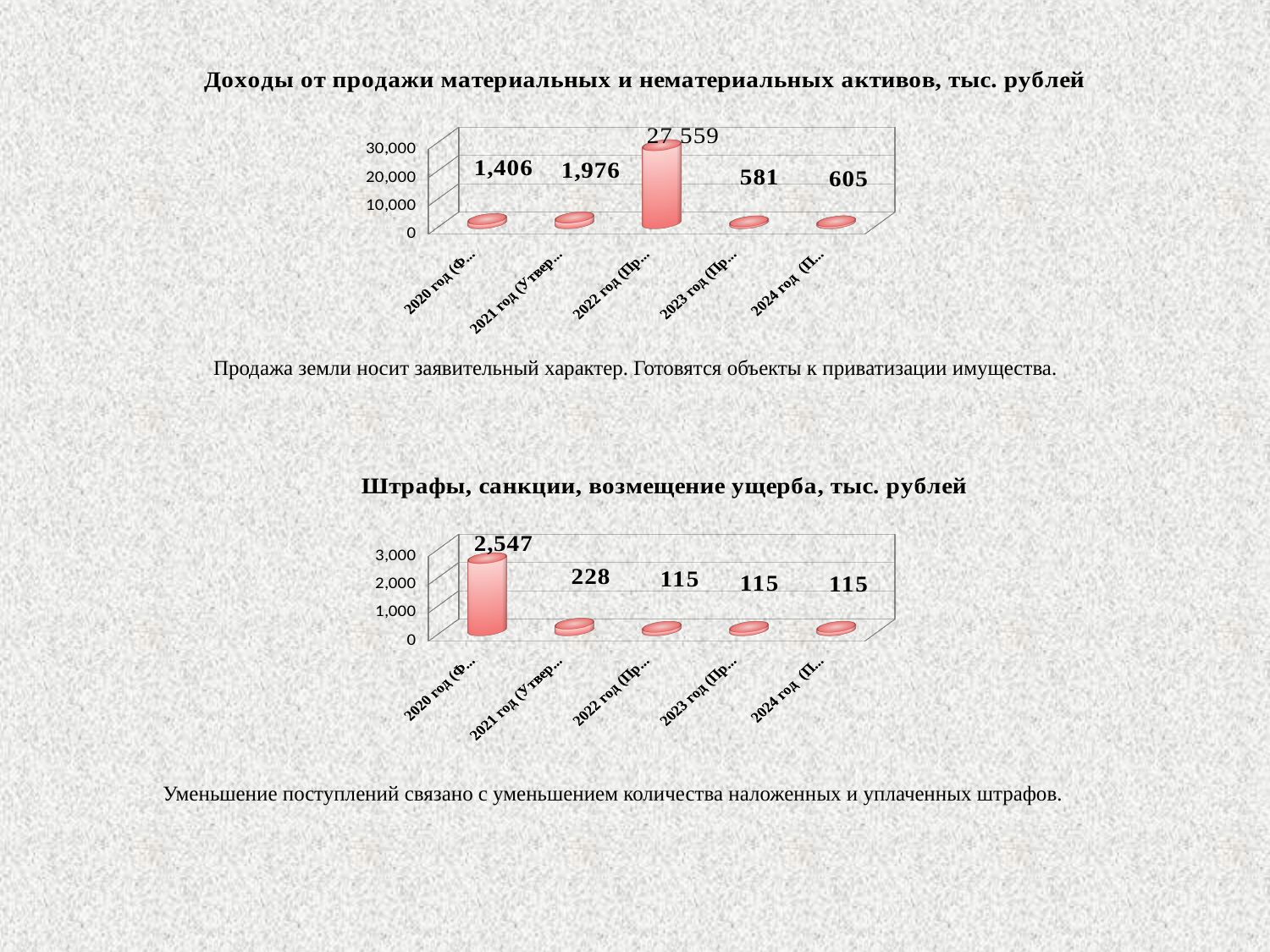
In the top chart (Доходы от продажи материальных и нематериальных активов), what is the value for 2020 год? 1,406 In the bottom chart (Штрафы, санкции, возмещение ущерба), which year has the highest value? 2020 год In the top chart (Доходы от продажи материальных и нематериальных активов), which year has the highest value? 2022 год In the top chart (Доходы от продажи материальных и нематериальных активов), which year has the lowest value? 2023 год In the top chart (Доходы от продажи материальных и нематериальных активов), how many years are plotted? 5 In the top chart (Доходы от продажи материальных и нематериальных активов), what is the value for 2023 год? 581 In the bottom chart (Штрафы, санкции, возмещение ущерба), is the value for 2020 год greater or less than 2,000? greater In the top chart (Доходы от продажи материальных и нематериальных активов), what is the value for 2021 год? 1,976 What kind of chart is the bottom chart (Штрафы, санкции, возмещение ущерба)? bar chart In the bottom chart (Штрафы, санкции, возмещение ущерба), what is the value for 2020 год? 2,547 In the bottom chart (Штрафы, санкции, возмещение ущерба), what is the value for 2021 год? 228 In the top chart (Доходы от продажи материальных и нематериальных активов), what is the difference between the values for 2021 год and 2020 год? 570